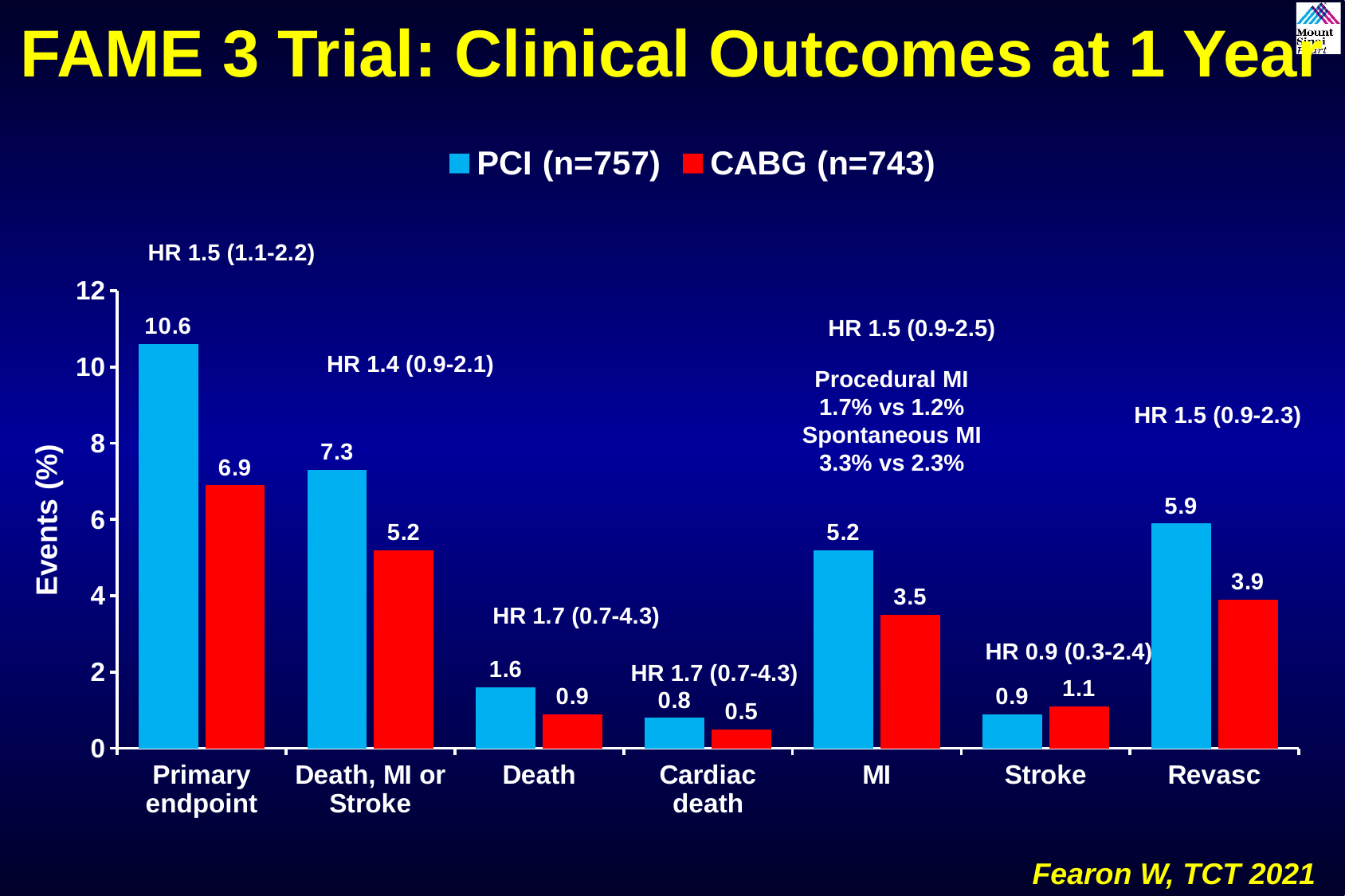
How many series does the legend list? 2 What is the CABG value for Death, MI or Stroke? 5.2 What kind of chart is shown on the slide? Bar chart What is the PCI value for the Primary endpoint? 10.6 For Stroke, which is larger, the PCI value or the CABG value? CABG Is the PCI value for Revasc greater or less than 4? greater Which category has the highest PCI value? Primary endpoint What is the difference between the PCI and CABG values for MI? 1.7 What is the CABG value for Revasc? 3.9 What is the difference between the PCI and CABG values for the Primary endpoint? 3.7 How many categories are shown on the x axis? 7 Which category has the lowest CABG value? Cardiac death